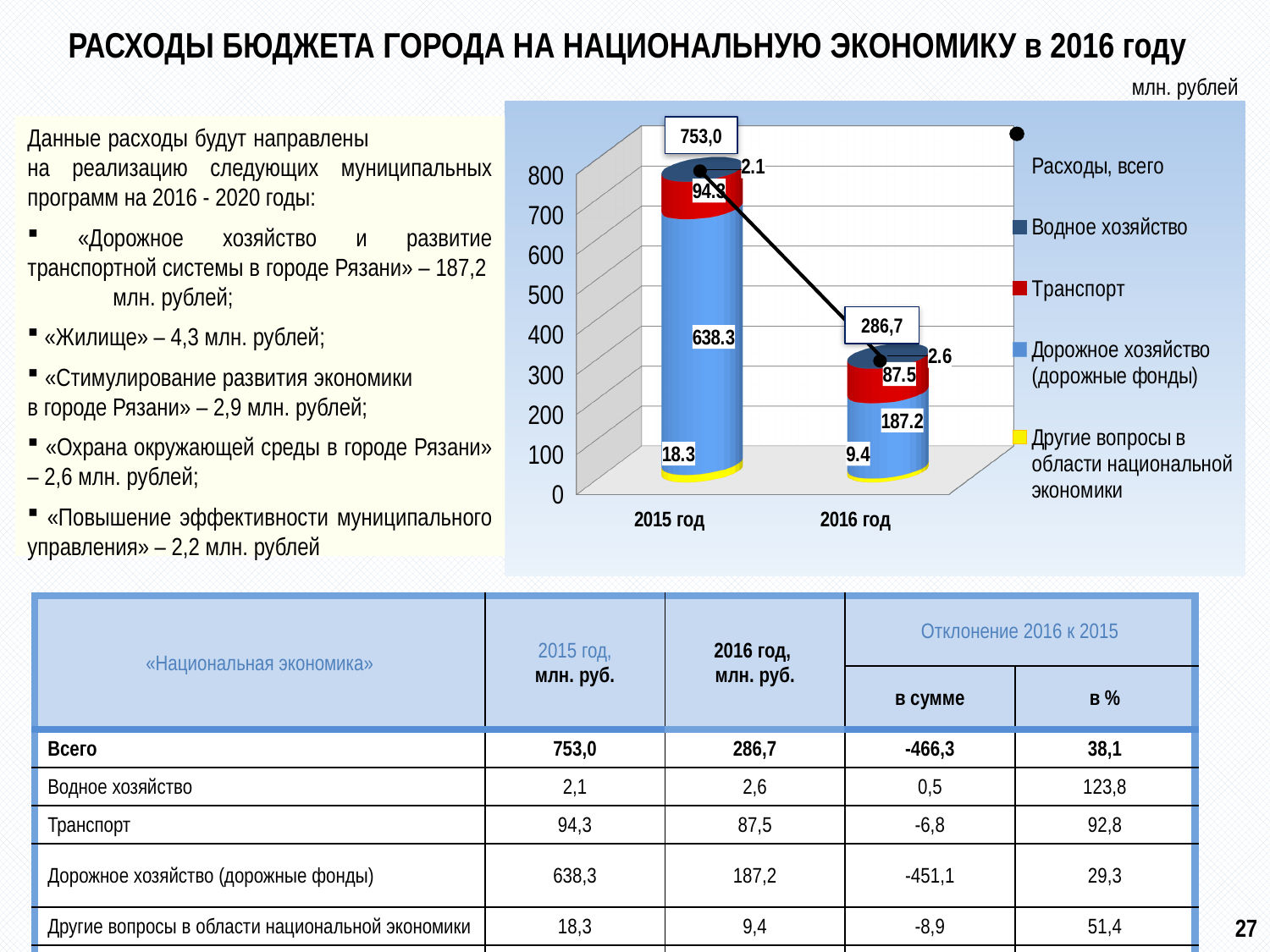
What is the value of Транспорт for 2016 год in the chart? 87.5 What is the value of Дорожное хозяйство (дорожные фонды) for 2015 год in the chart? 638.3 What type of chart is shown on the slide? Stacked bar chart By how much does the Дорожное хозяйство (дорожные фонды) value for 2015 год exceed that for 2016 год? 451.1 What is the value of Дорожное хозяйство (дорожные фонды) for 2016 год in the chart? 187.2 How many categories are shown on the x axis of the chart? 2 What is the total Расходы, всего value shown for 2015 год? 753,0 What is the total Расходы, всего value shown for 2016 год? 286,7 How many series does the chart legend list? 5 Does the total expenditure rise or fall from 2015 год to 2016 год? Fall What is the value of Другие вопросы в области национальной экономики for 2015 год in the chart? 18.3 Which year has the higher total expenditure in the chart, 2015 год or 2016 год? 2015 год